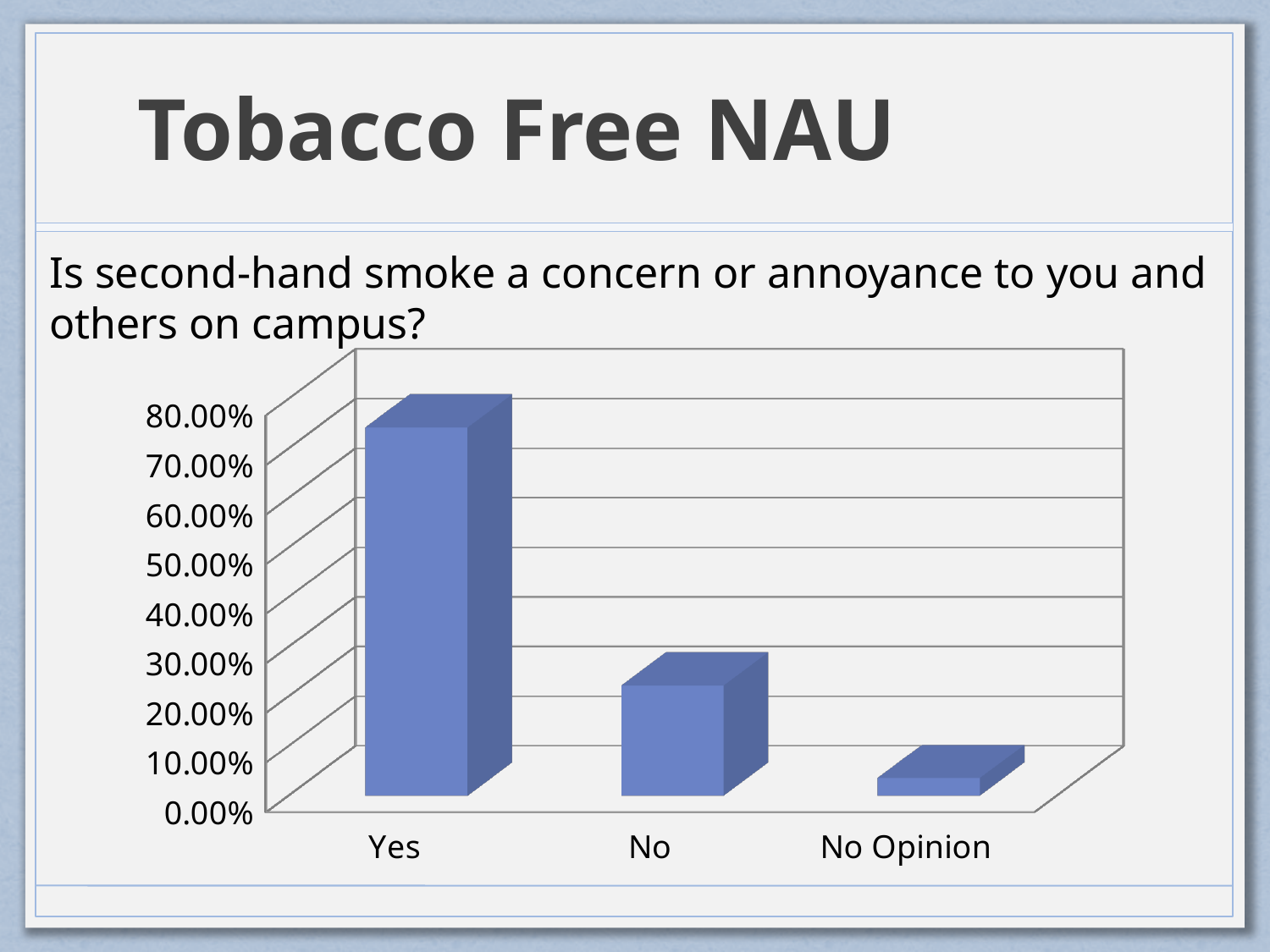
Which is larger, the value for No or the value for No Opinion? No Which is larger, the value for Yes or the value for No? Yes Is the value for Yes greater or less than 60.00%? greater Is the value for No greater or less than 30.00%? less What question does the chart on the slide present responses to? Is second-hand smoke a concern or annoyance to you and others on campus? Is the value for No Opinion greater or less than 10.00%? less What kind of chart is shown on the slide? bar chart Do the values rise or fall moving from left to right along the x axis? fall Which category has the lowest value in the chart? No Opinion How many categories are shown on the x axis of the chart? 3 Which category has the highest value in the chart? Yes